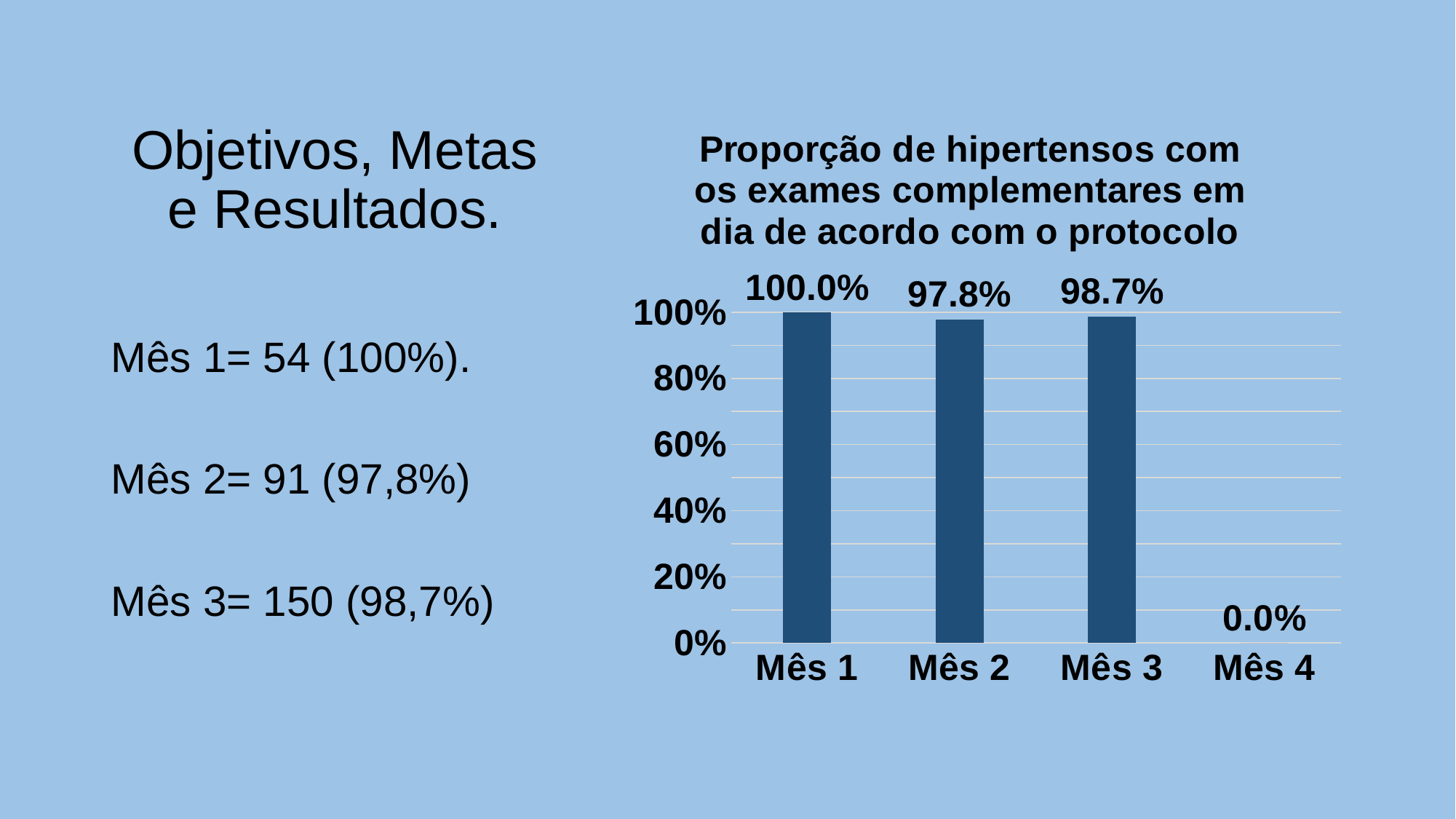
What is the value for Mês 1? 100.0% Which is larger, the value for Mês 2 or Mês 3? Mês 3 What is the value for Mês 4? 0.0% How many categories are shown on the x axis? 4 What is the difference between the values for Mês 1 and Mês 2? 2.2% Is the value for Mês 2 greater or less than 80%? greater Which month has the lowest value? Mês 4 What is the value for Mês 3? 98.7% What is the title of the chart? Proporção de hipertensos com os exames complementares em dia de acordo com o protocolo What is the value for Mês 2? 97.8% What kind of chart is shown? bar chart Which month has the highest value? Mês 1